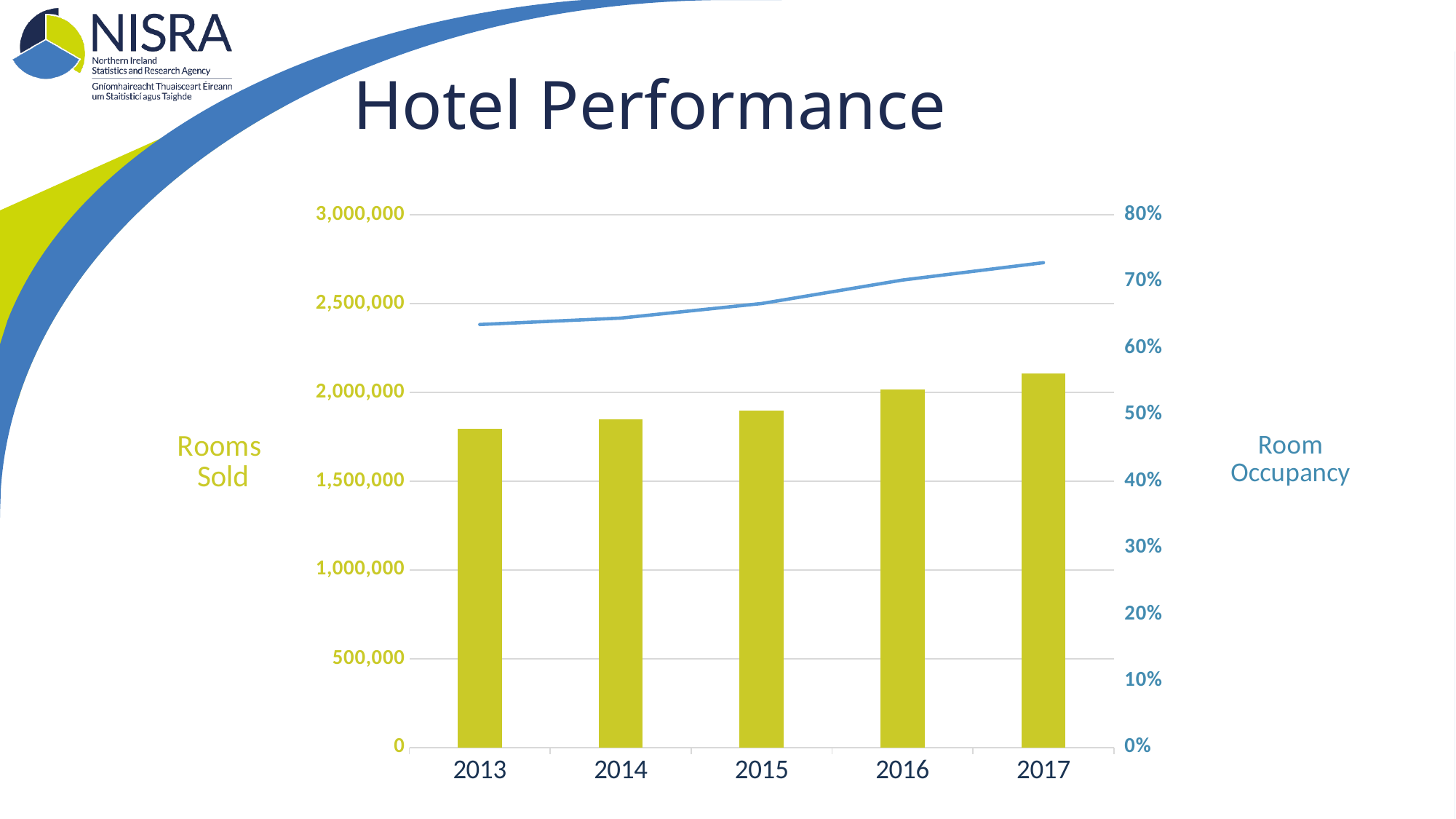
Which year had more rooms sold, 2014 or 2016? 2016 Is the room occupancy in 2017 greater or less than 70%? greater How many years are shown on the x axis of the chart? 5 What type of chart is shown on the slide? A combined bar and line chart Is the room occupancy in 2013 greater or less than 60%? greater What does the left-hand axis of the chart measure? Rooms Sold Is the number of rooms sold in 2017 greater or less than 2,000,000? greater Which year has the lowest number of rooms sold? 2013 What is the title of the slide? Hotel Performance Which year has the highest number of rooms sold? 2017 Does room occupancy rise or fall from 2013 to 2017? rise